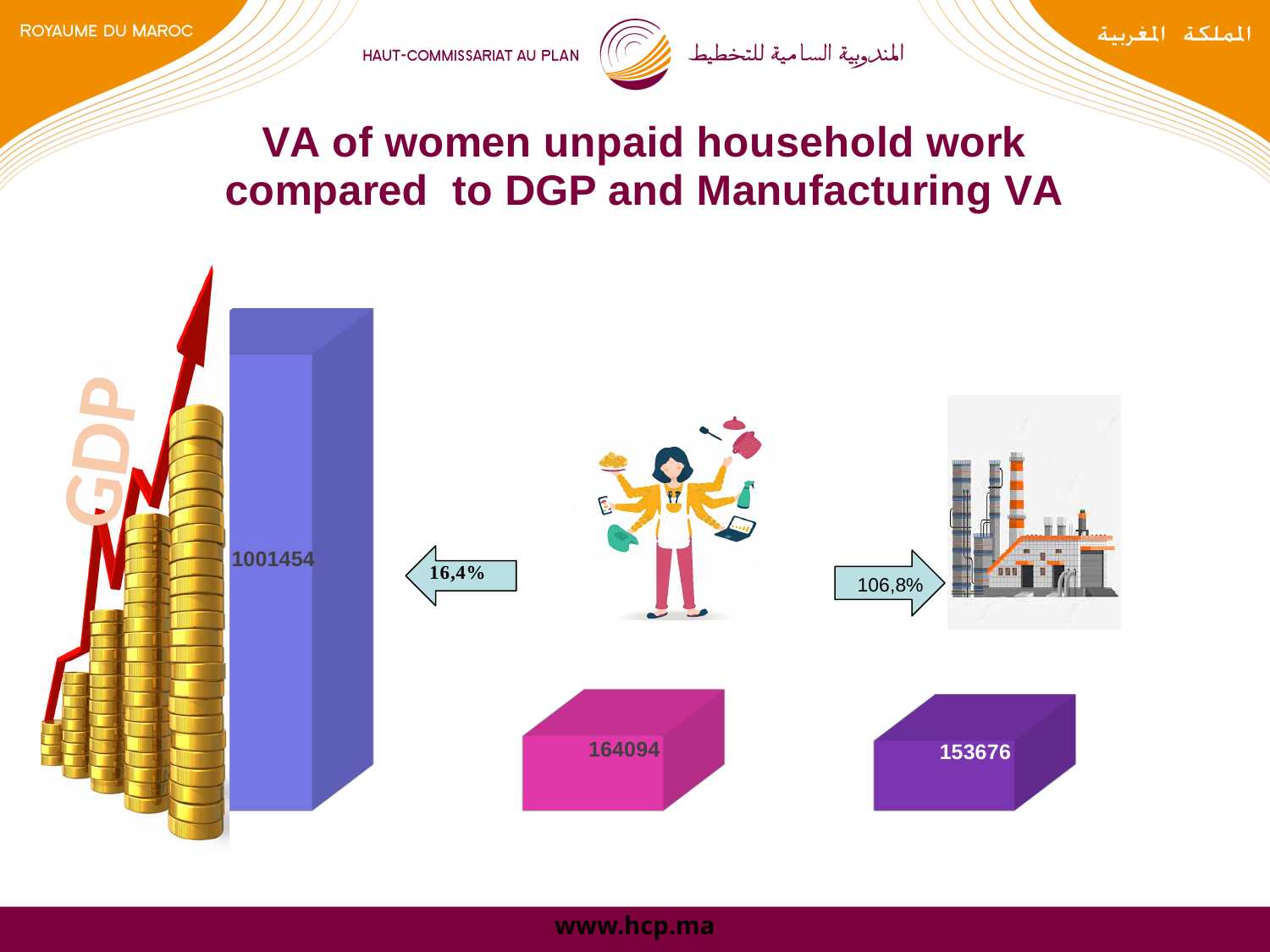
What kind of chart is shown on the slide? Bar chart What is the value shown for GDP? 1001454 Which of the three bars has the lowest value? Manufacturing VA (153676) What is the difference between the VA of women unpaid household work and Manufacturing VA? 10418 How many bars are shown on the slide? 3 Which of the three bars has the highest value? GDP Which is larger: the VA of women unpaid household work or Manufacturing VA? VA of women unpaid household work What is the difference between GDP and the VA of women unpaid household work? 837360 What is the value shown for Manufacturing VA (the right bar)? 153676 What is the value shown for the VA of women unpaid household work (the middle bar)? 164094 What percentage is shown in the arrow pointing from the woman icon toward the GDP bar? 16,4% What percentage is shown in the arrow pointing toward the factory icon? 106,8%